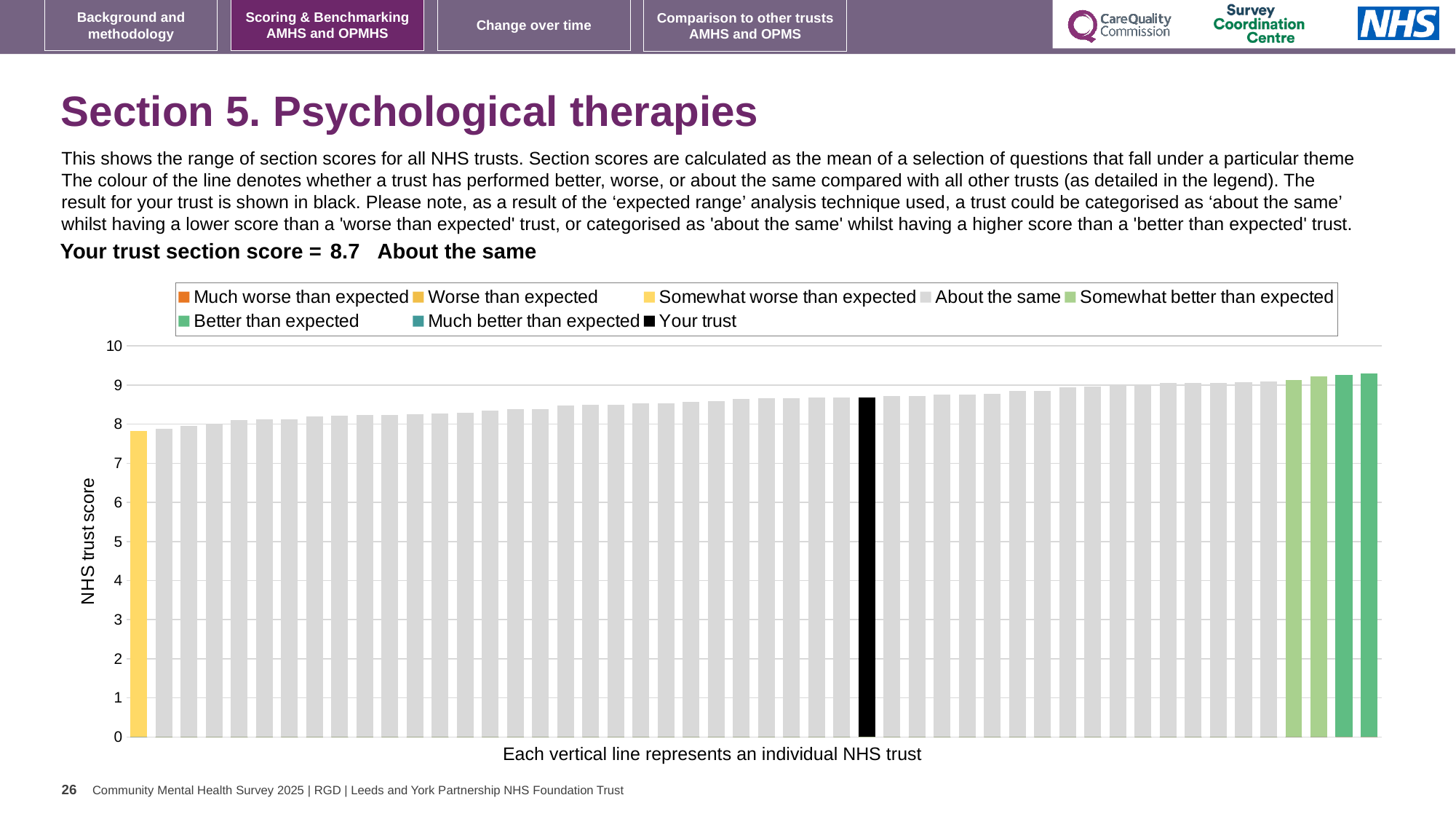
How many bars are coloured yellow (worse than expected) in the chart? 1 Is the value of the rightmost bar greater or less than 9? greater Is the black 'Your trust' bar higher or lower than the yellow 'Worse than expected' bar? higher How many entries does the chart legend list? 8 What is the section score for your trust shown on the slide? 8.7 Is the value of the black 'Your trust' bar greater or less than 8? greater Is the value of the leftmost (yellow) bar greater or less than 9? less What is the label on the vertical axis of the chart? NHS trust score What colour is the bar representing your trust? black Which category is your trust placed in for this section? About the same Do the bar values rise or fall from left to right across the chart? rise What kind of chart is shown on the slide? bar chart